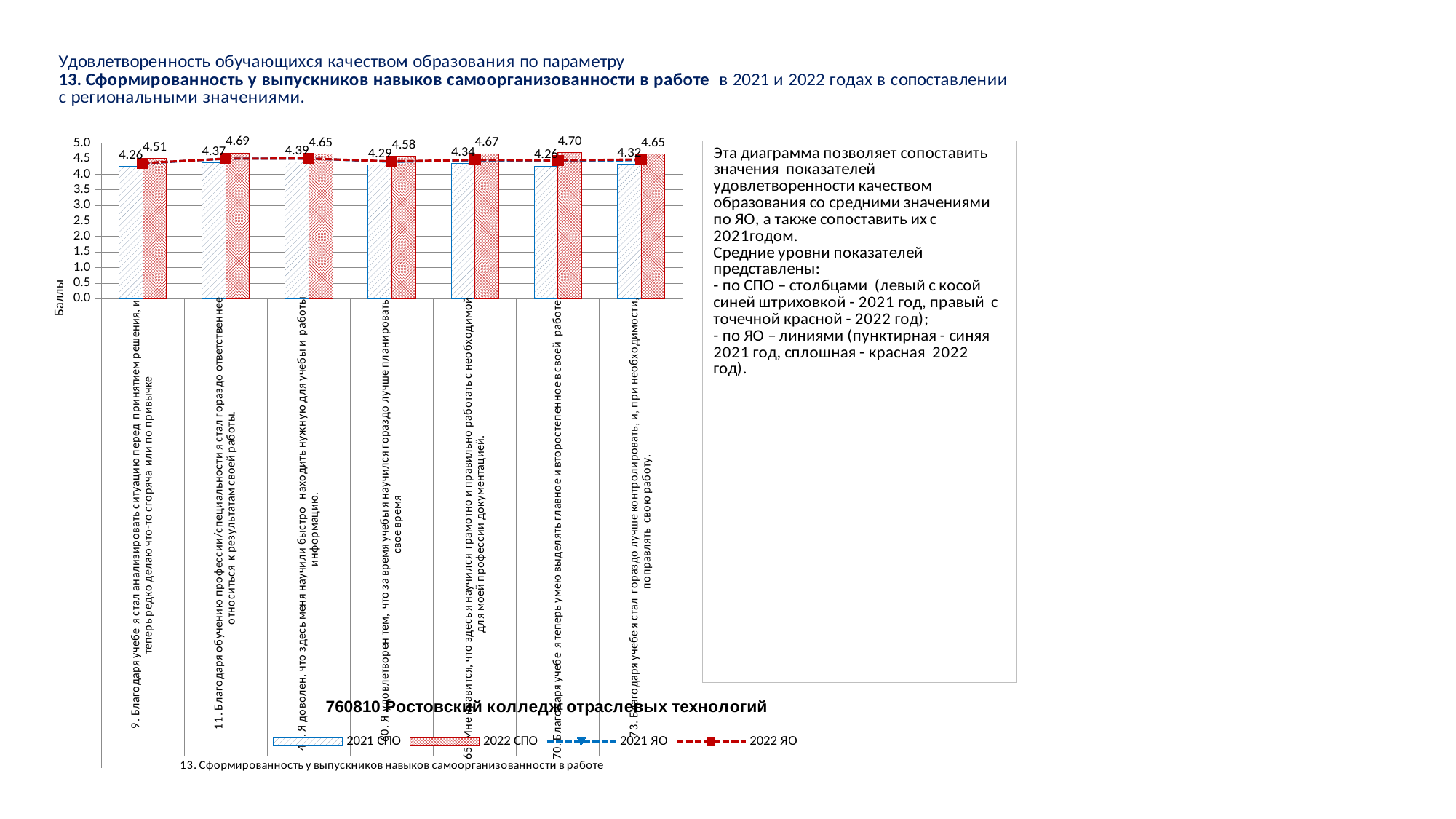
How many series does the chart legend list? 4 For statement 11, which is larger: the 2021 СПО value or the 2022 СПО value? 2022 СПО (4.69) What is the 2022 СПО value for statement 73 ("Благодаря учебе я стал гораздо лучше контролировать, и, при необходимости поправлять свою работу")? 4.65 What type of chart is shown on the slide? bar chart (with line series) How many categories (statements) are plotted along the x axis? 7 What is the 2022 СПО value for statement 11 ("Благодаря обучению профессии/специальности я стал гораздо ответственнее относиться к результатам своей работы")? 4.69 Which statement has the highest 2021 СПО value? Я доволен, что здесь меня научили быстро находить нужную для учебы и работы информацию (4.39) Which statement has the highest 2022 СПО value? 70. Благодаря учебе я теперь умею выделять главное и второстепенное в своей работе (4.70) What is the difference between the 2022 СПО and 2021 СПО values for statement 70? 0.44 What is the label of the vertical axis? Баллы Which statement has the lowest 2022 СПО value? 9. Благодаря учебе я стал анализировать ситуацию перед принятием решения... (4.51)